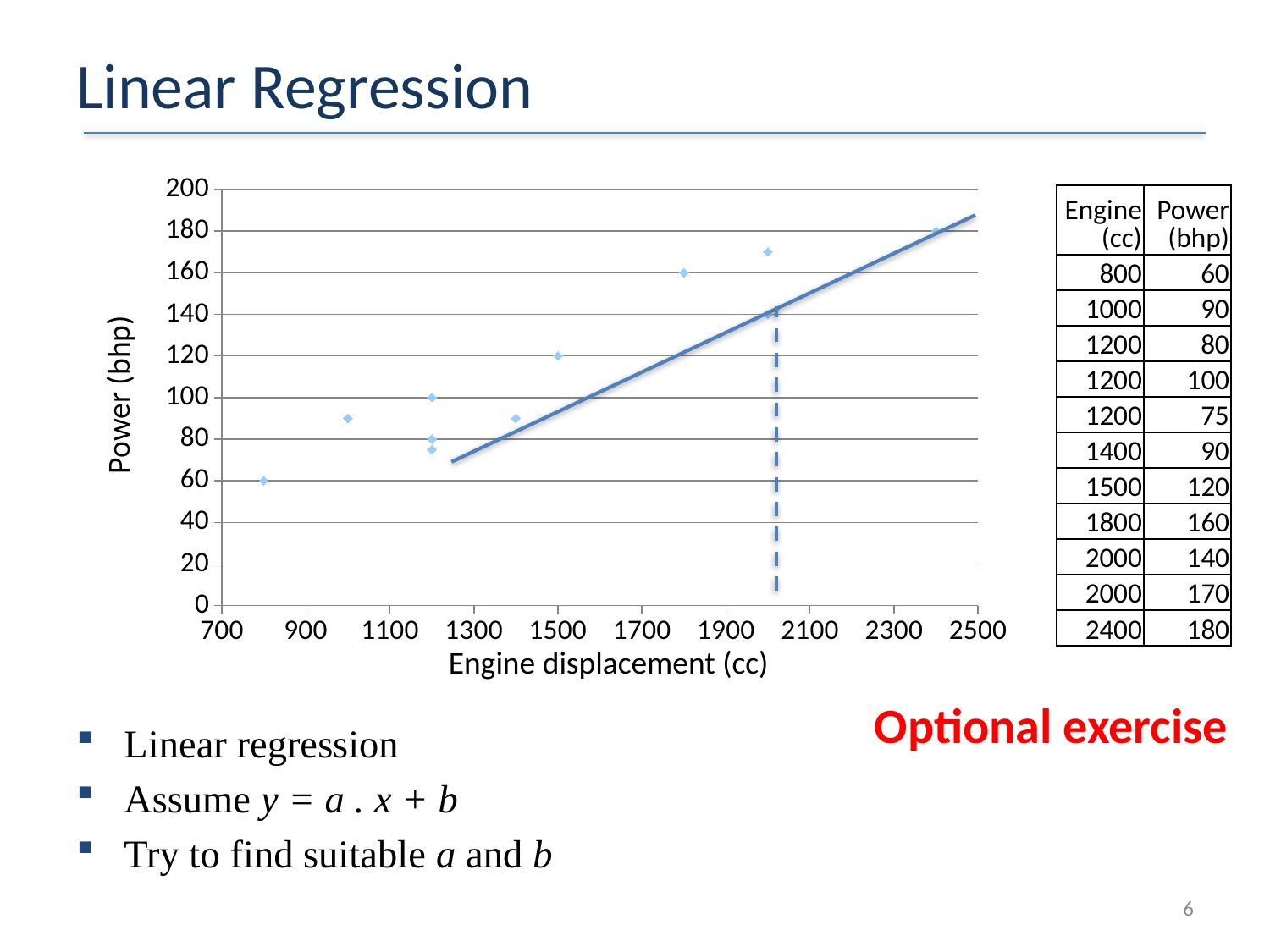
Which engine displacement has the highest power? 2400 What is the title of the y axis of the chart? Power (bhp) Does power generally rise or fall as engine displacement increases along the x axis? rise What is the difference in power between the 2400 cc engine and the 800 cc engine? 120 Which engine displacement has the lowest power? 800 What is the power (bhp) for the engine with 1400 cc displacement? 90 What is the power (bhp) for the engine with 1800 cc displacement? 160 What kind of chart is shown on the slide? Scatter chart Is the power for the 1500 cc engine greater or less than 100? greater What is the title of the x axis of the chart? Engine displacement (cc) Which has higher power, the 1800 cc engine or the 1500 cc engine? 1800 cc How many data points are plotted on the chart? 11